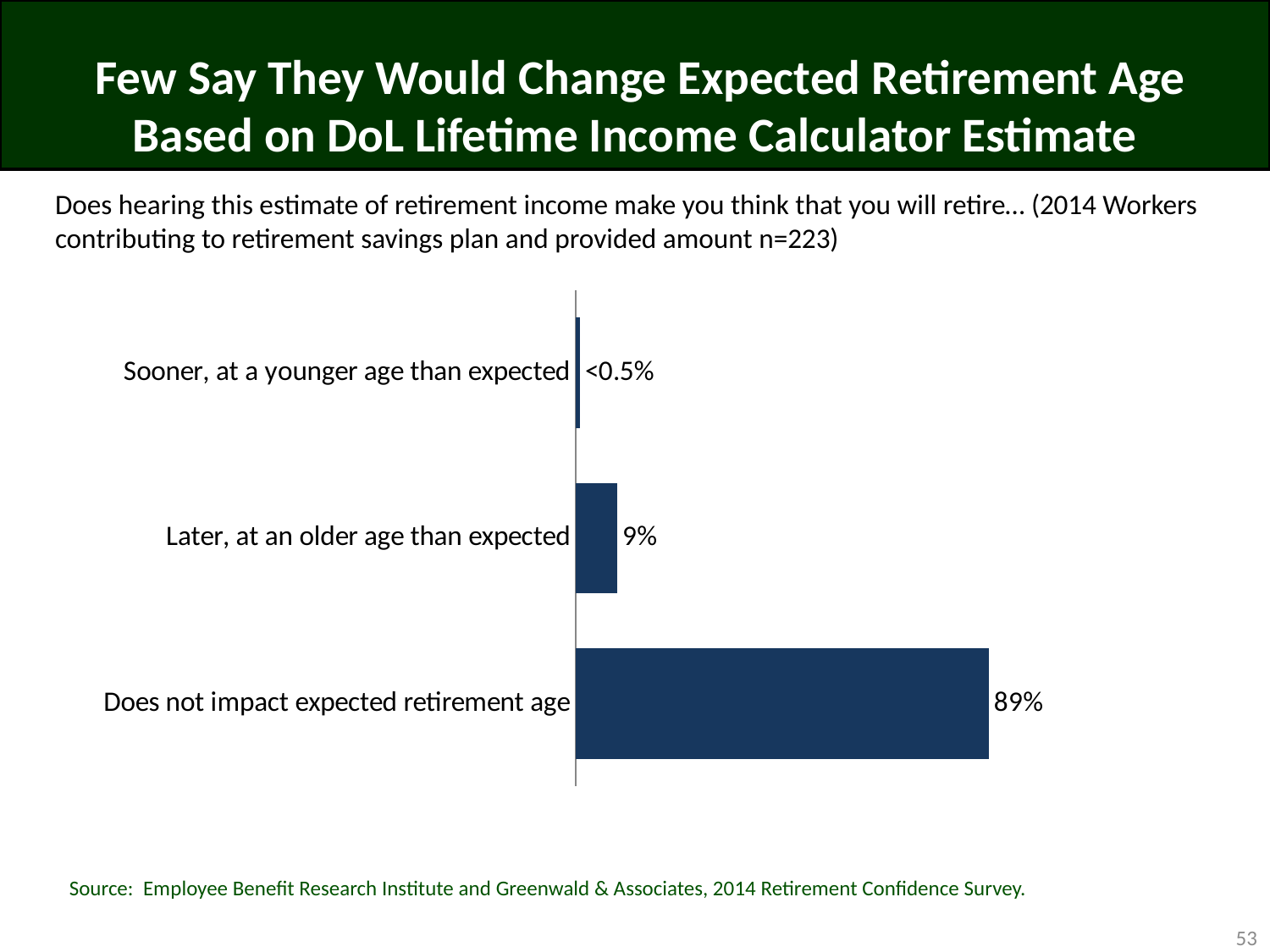
What value is shown for 'Sooner, at a younger age than expected'? <0.5% What type of chart is shown on the slide? Bar chart What is the sample size (n) stated for the survey question on the slide? 223 How many response categories are shown in the chart? 3 What percentage of workers said they would retire later, at an older age than expected? 9% Which response category has the lowest value? Sooner, at a younger age than expected What is the difference in percentage points between 'Does not impact expected retirement age' and 'Later, at an older age than expected'? 80 percentage points What is the source cited for the chart? Employee Benefit Research Institute and Greenwald & Associates, 2014 Retirement Confidence Survey What percentage of workers said the estimate does not impact their expected retirement age? 89% Which is larger: the value for 'Later, at an older age than expected' or the value for 'Sooner, at a younger age than expected'? Later, at an older age than expected Which response category has the highest value? Does not impact expected retirement age